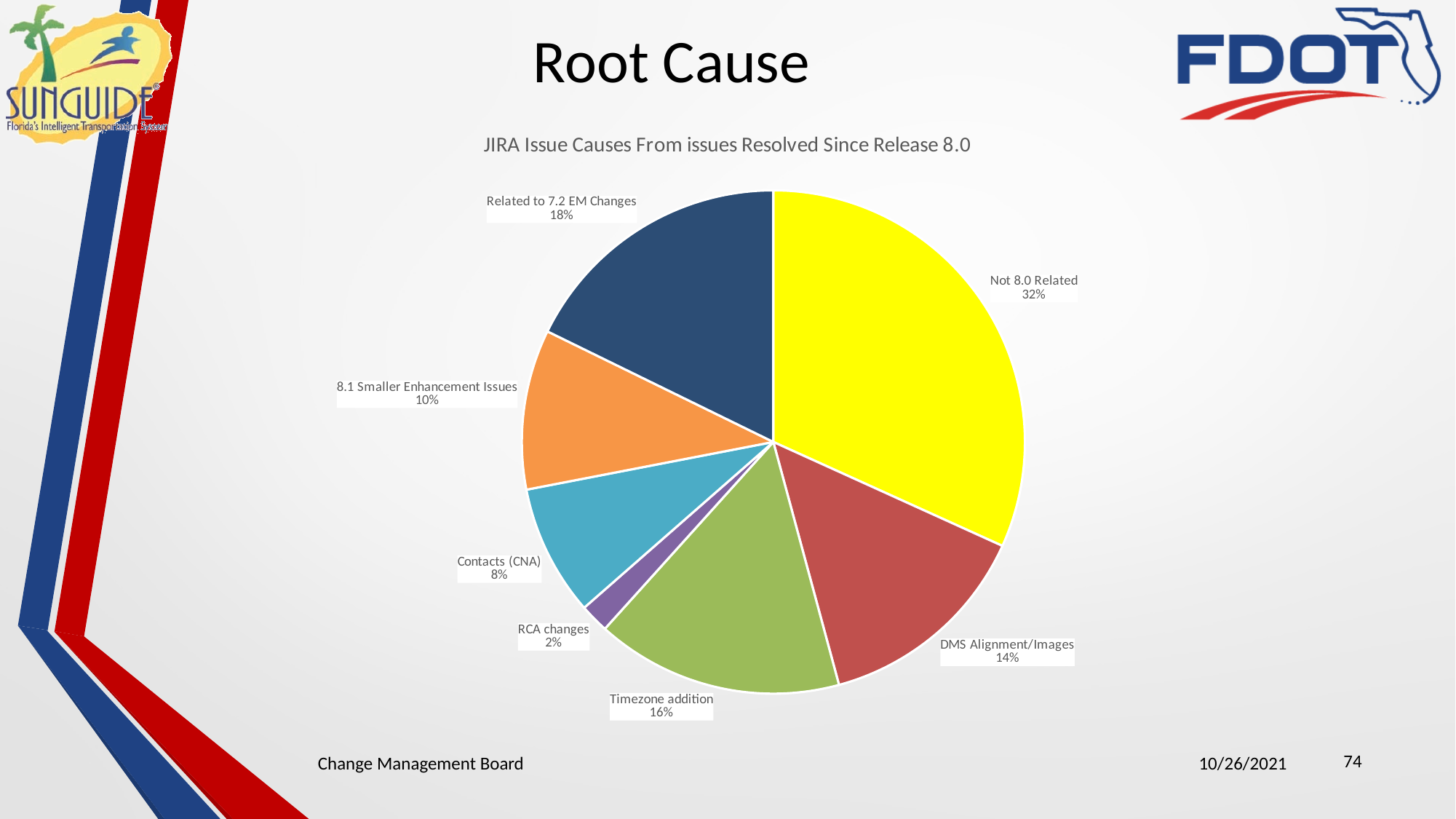
What share of the pie is "Timezone addition"? 16% What is the difference in percentage points between "Related to 7.2 EM Changes" and "DMS Alignment/Images"? 4 What percentage is shown for "RCA changes"? 2% Which is larger, "8.1 Smaller Enhancement Issues" or "Contacts (CNA)"? 8.1 Smaller Enhancement Issues Which category has the largest slice of the pie? Not 8.0 Related What percentage of issues is labelled "Not 8.0 Related"? 32% What colour is the "Not 8.0 Related" slice? Yellow How many categories are shown in the pie chart? 7 What is the title of the chart? JIRA Issue Causes From issues Resolved Since Release 8.0 Which category has the smallest slice of the pie? RCA changes What type of chart is shown on the slide? Pie chart What percentage is shown for "Contacts (CNA)"? 8%